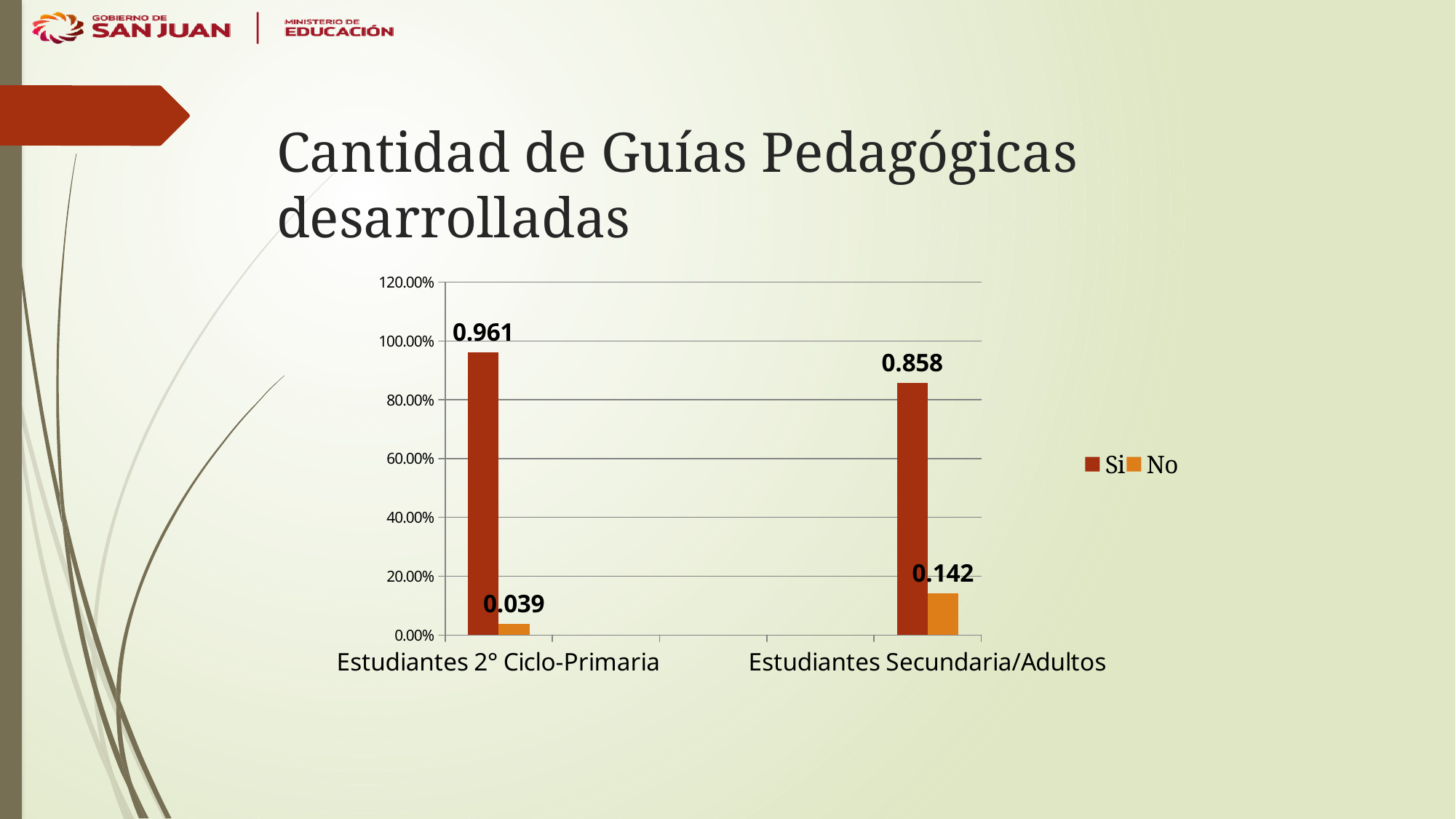
What is the value of the Si series for Estudiantes Secundaria/Adultos? 0.858 Which category has the lowest No value? Estudiantes 2° Ciclo-Primaria How many series does the legend list? 2 How many categories are shown on the x axis? 2 What is the value of the No series for Estudiantes Secundaria/Adultos? 0.142 What is the value of the Si series for Estudiantes 2° Ciclo-Primaria? 0.961 Which is larger: the No value for Estudiantes Secundaria/Adultos or the No value for Estudiantes 2° Ciclo-Primaria? Estudiantes Secundaria/Adultos What kind of chart is shown on the slide? bar chart Which category has the highest Si value? Estudiantes 2° Ciclo-Primaria What is the value of the No series for Estudiantes 2° Ciclo-Primaria? 0.039 What is the difference between the Si values for Estudiantes 2° Ciclo-Primaria and Estudiantes Secundaria/Adultos? 0.103 Is the Si bar for Estudiantes Secundaria/Adultos greater or less than 80.00%? greater